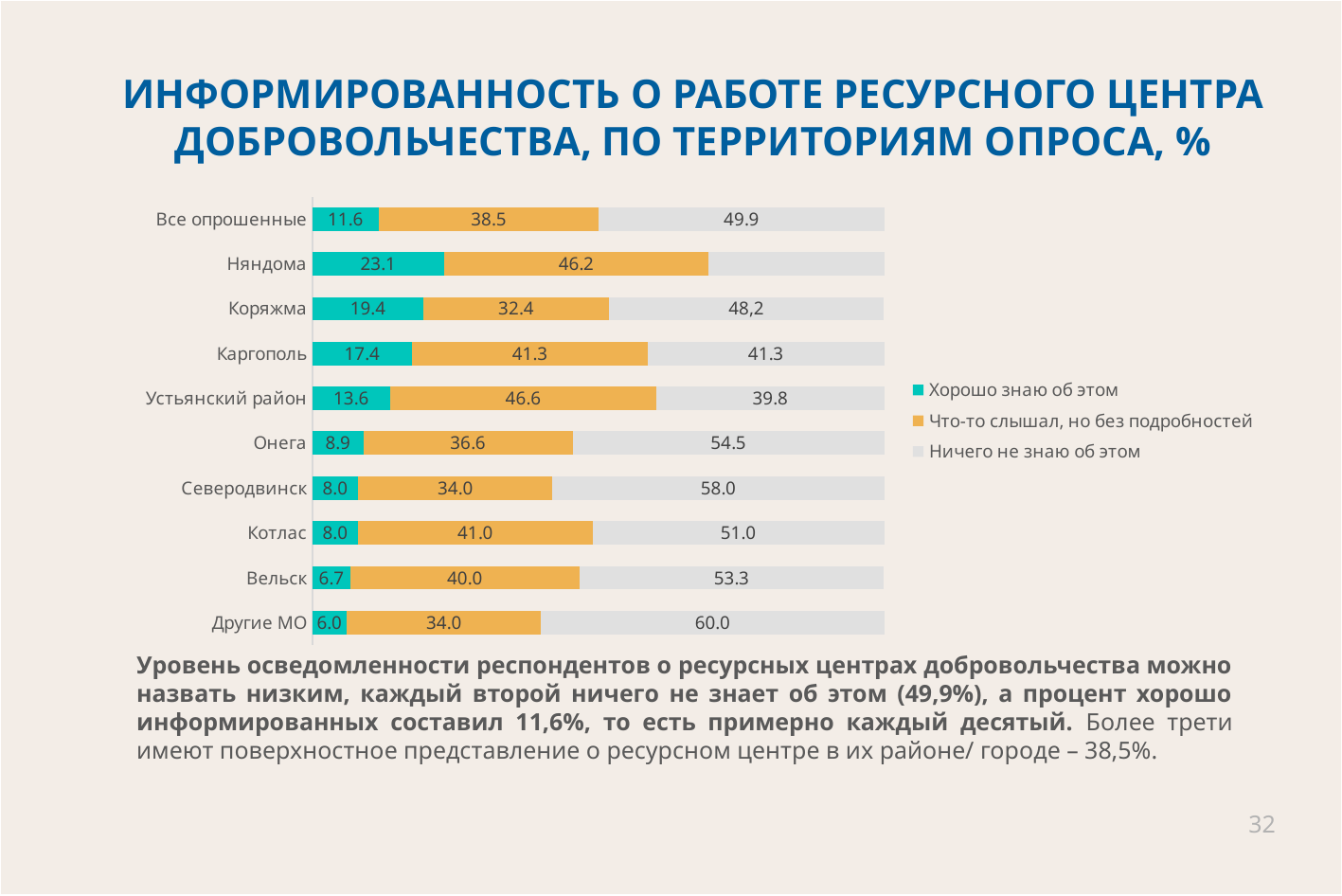
How many series does the legend list? 3 What is the difference between the "Ничего не знаю об этом" values for Северодвинск and Котлас? 7.0 What is the value of "Хорошо знаю об этом" for Все опрошенные? 11.6 What is the value of "Что-то слышал, но без подробностей" for Устьянский район? 46.6 Which territory has the highest value for "Хорошо знаю об этом"? Няндома Which is larger: the "Что-то слышал, но без подробностей" value for Каргополь or for Онега? Каргополь How many territories (categories) are shown on the chart? 10 What kind of chart is shown on the slide? Stacked bar chart Which territory has the highest value for "Ничего не знаю об этом"? Другие МО Which territory has the lowest value for "Хорошо знаю об этом"? Другие МО What is the value of "Ничего не знаю об этом" for Другие МО? 60.0 Which series is shown in orange in the legend? Что-то слышал, но без подробностей